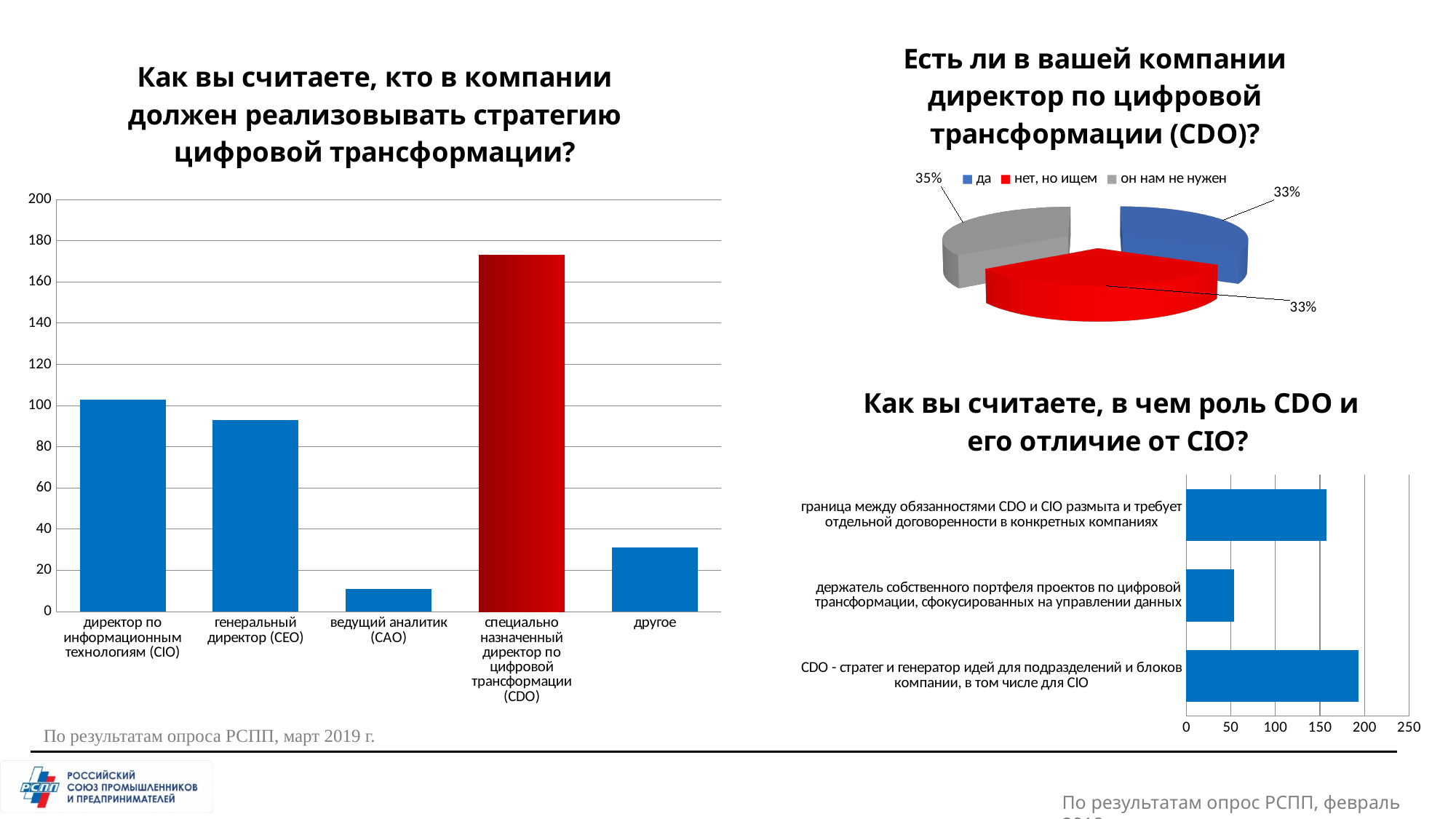
In the chart titled 'Как вы считаете, в чем роль CDO и его отличие от CIO?', which category has the highest value? CDO - стратег и генератор идей для подразделений и блоков компании, в том числе для CIO In the chart titled 'Как вы считаете, кто в компании должен реализовывать стратегию цифровой трансформации?', which category has the highest value? специально назначенный директор по цифровой трансформации (CDO) In the chart titled 'Как вы считаете, кто в компании должен реализовывать стратегию цифровой трансформации?', which category has the lowest value? ведущий аналитик (CAO) How many entries does the legend list in the pie chart titled 'Есть ли в вашей компании директор по цифровой трансформации (CDO)?'? 3 In the chart titled 'Как вы считаете, кто в компании должен реализовывать стратегию цифровой трансформации?', is the value for 'специально назначенный директор по цифровой трансформации (CDO)' greater or less than 160? greater In the pie chart titled 'Есть ли в вашей компании директор по цифровой трансформации (CDO)?', what share does 'да' have? 33% In the chart titled 'Как вы считаете, кто в компании должен реализовывать стратегию цифровой трансформации?', which is larger: the value for 'директор по информационным технологиям (CIO)' or for 'генеральный директор (CEO)'? директор по информационным технологиям (CIO) In the chart titled 'Как вы считаете, в чем роль CDO и его отличие от CIO?', is the value for 'держатель собственного портфеля проектов по цифровой трансформации, сфокусированных на управлении данных' greater or less than 100? less How many categories are shown in the chart titled 'Как вы считаете, кто в компании должен реализовывать стратегию цифровой трансформации?'? 5 In the pie chart titled 'Есть ли в вашей компании директор по цифровой трансформации (CDO)?', what share does 'он нам не нужен' have? 35% In the chart titled 'Как вы считаете, кто в компании должен реализовывать стратегию цифровой трансформации?', is the value for 'другое' greater or less than 40? less What kind of chart is the one titled 'Есть ли в вашей компании директор по цифровой трансформации (CDO)?'? pie chart